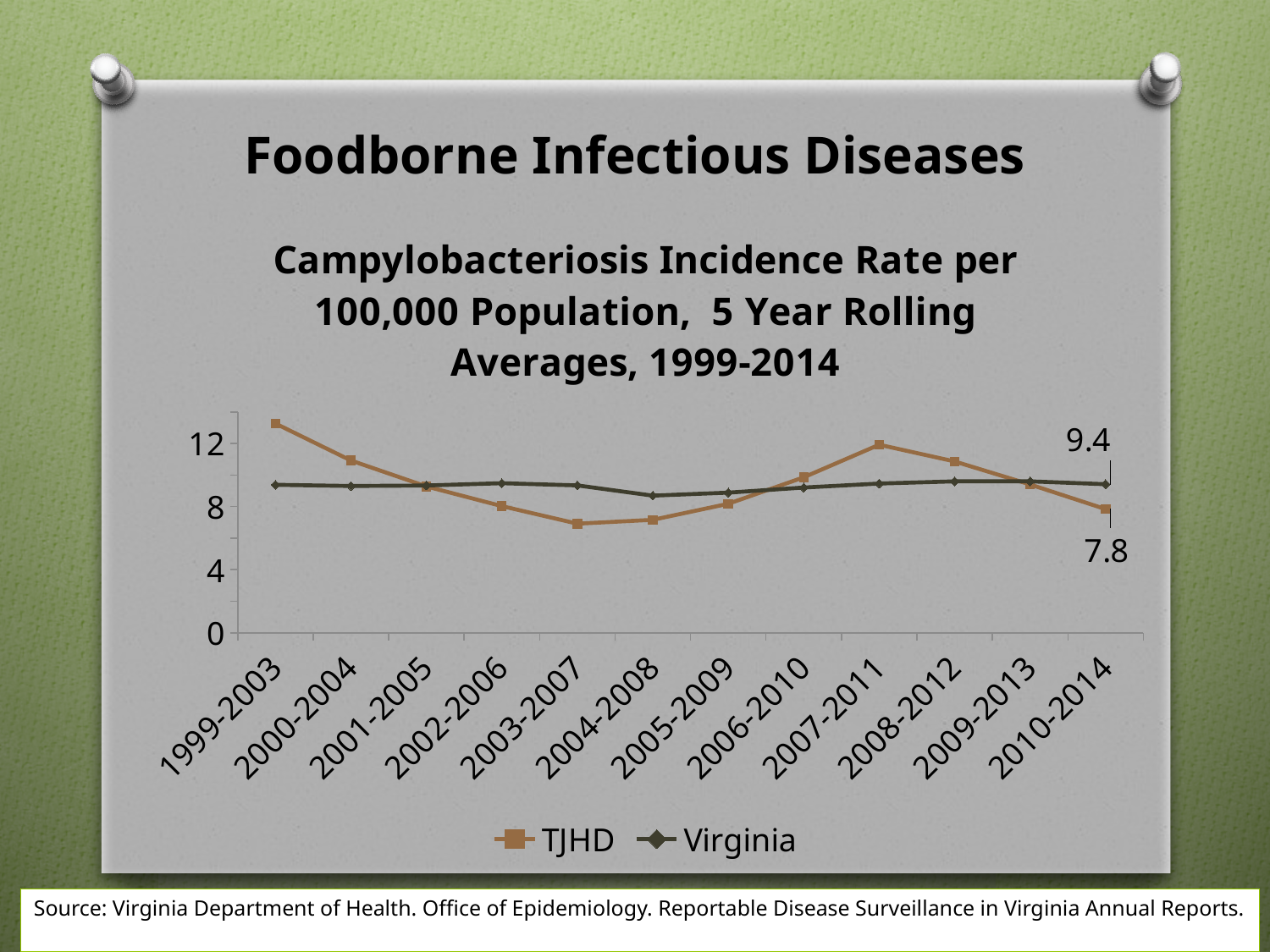
Is the TJHD value for 1999-2003 greater or less than 12? greater What kind of chart is shown on the slide? Line chart In which period is the TJHD value highest? 1999-2003 Is the Virginia value for 2003-2007 greater or less than 8? greater For 2010-2014, which series has the higher value, TJHD or Virginia? Virginia How many series does the legend list? 2 What are the two series named in the legend? TJHD and Virginia What is the TJHD value for 2010-2014? 7.8 How many 5-year periods are shown on the x axis? 12 Is the TJHD value for 2003-2007 greater or less than 8? less What is the Virginia value for 2010-2014? 9.4 What is the difference between the Virginia and TJHD values for 2010-2014? 1.6